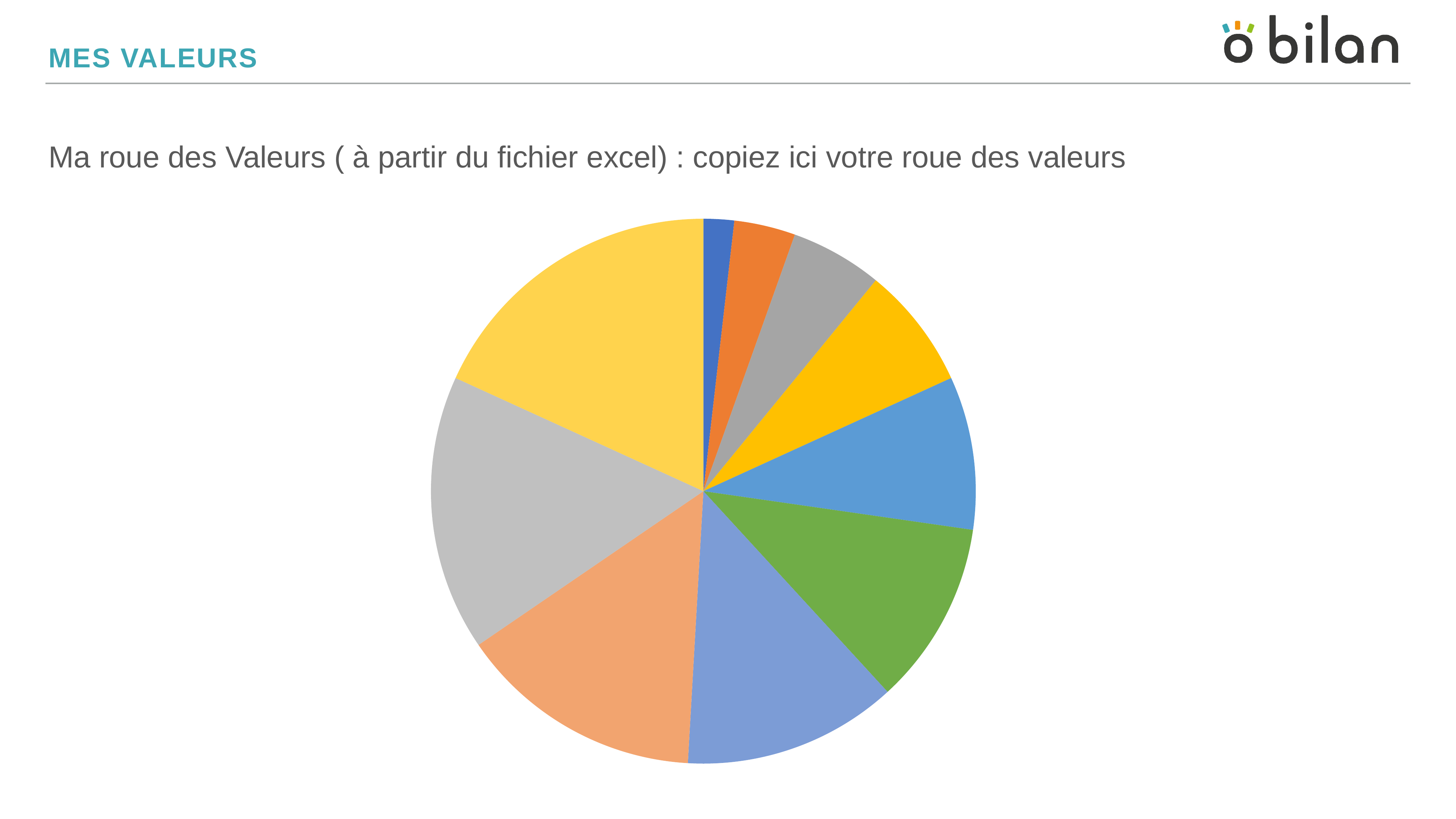
Which slice is larger, the light yellow slice at the top left or the green slice on the right? the light yellow slice Which slice is larger, the periwinkle blue slice at the bottom or the gold slice at the top right? the periwinkle blue slice Which slice of the pie chart is the smallest? the dark blue slice at the top What is the heading of the slide containing the pie chart? MES VALEURS What kind of chart is shown on the slide? pie chart Which slice is larger, the large grey slice on the left or the dark blue slice at the top? the large grey slice Does the pie chart display a legend? No How many slices does the pie chart have? 10